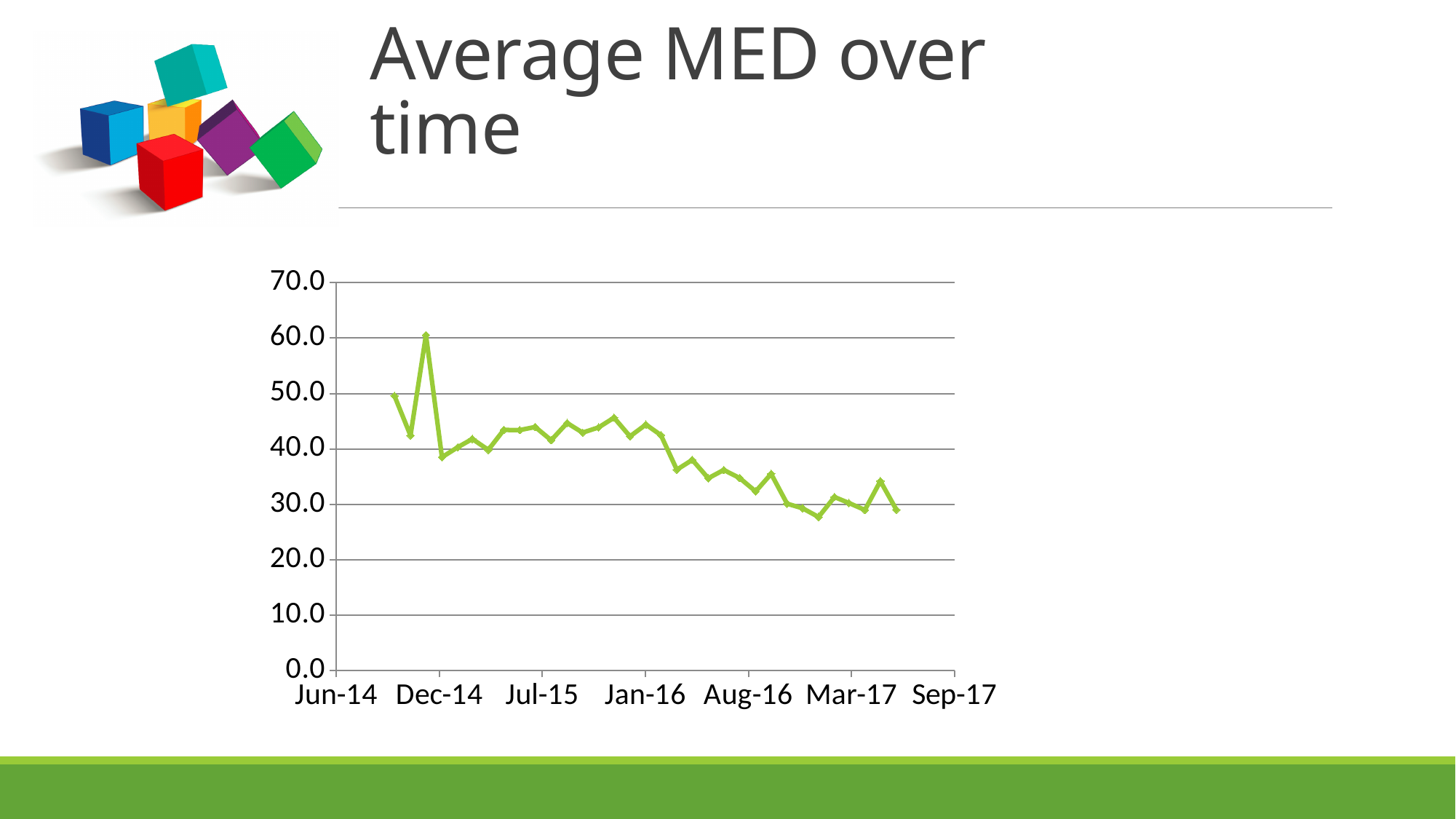
Overall, do the values rise or fall from Jun-14 to Sep-17? fall What kind of chart is shown on the slide? line chart Is the value plotted around Aug-16 greater or less than 40? less What is the title of the slide containing the chart? Average MED over time How many date labels are shown on the horizontal axis? 7 Is the highest value on the chart greater or less than 50? greater What is the maximum value shown on the vertical axis? 70.0 Is the value plotted around Mar-17 greater or less than 20? greater How many lines (series) are plotted on the chart? 1